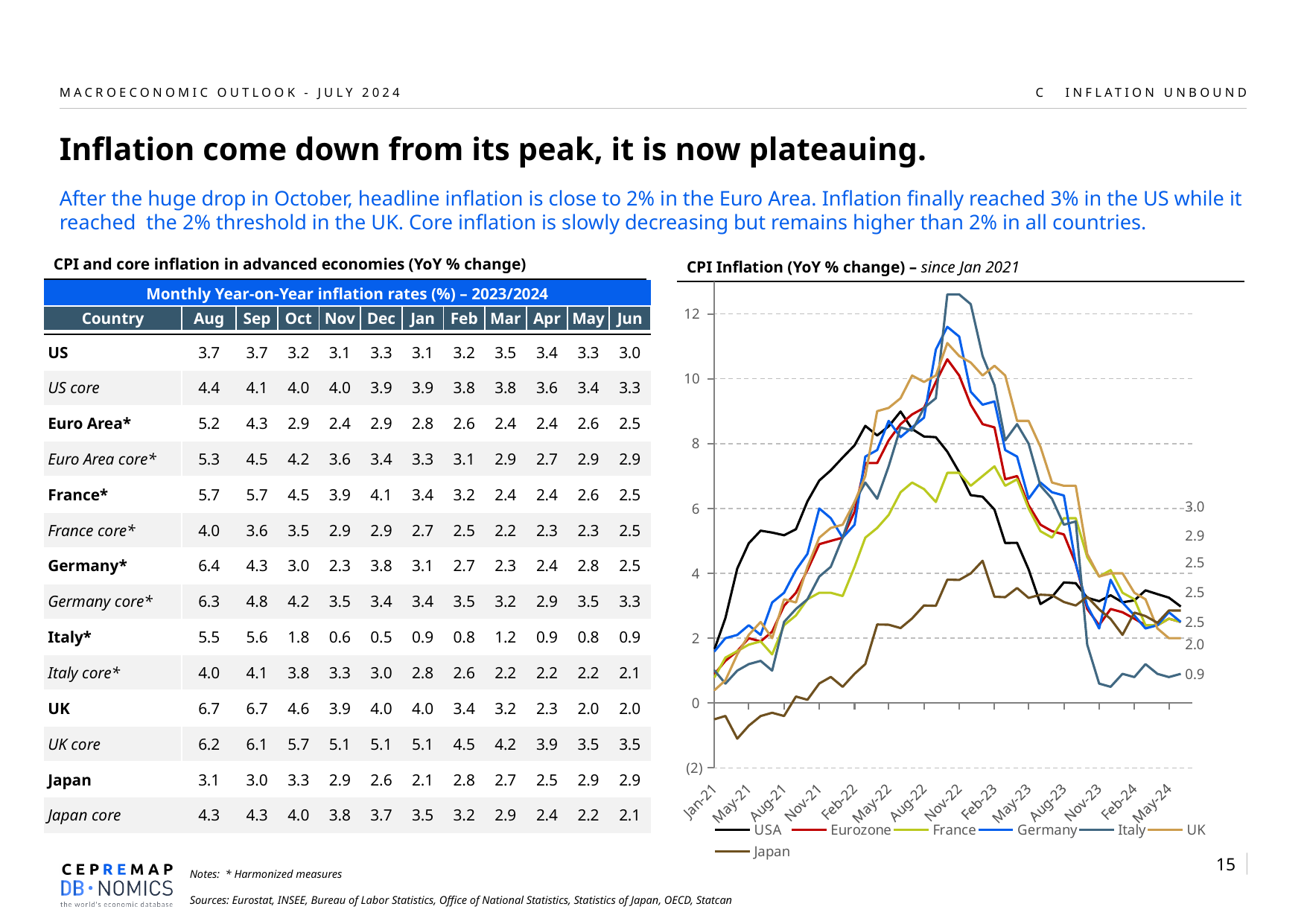
In the CPI Inflation chart, what is the highest value labelled at the right end of the lines? 3.0 What kind of chart is shown on the right side of the slide? line chart In the CPI Inflation chart, what is the lowest value shown on the y axis? (2) In the CPI Inflation chart, which series has the lowest value at Jan-21? Japan In the CPI Inflation chart, what is the lowest value labelled at the right end of the lines? 0.9 How many series does the legend of the CPI Inflation chart list? 7 What is the title of the chart on the right side of the slide? CPI Inflation (YoY % change) – since Jan 2021 In the CPI Inflation chart, does the USA series rise or fall between Jan-21 and Feb-22? rise In the CPI Inflation chart, is the peak value of the Italy series greater or less than 12? greater In the CPI Inflation chart, is the peak of the USA series greater or less than 10? less In the CPI Inflation chart, is the Japan series at Jan-21 greater or less than 0? less In the CPI Inflation chart, which series reaches the highest peak? Italy